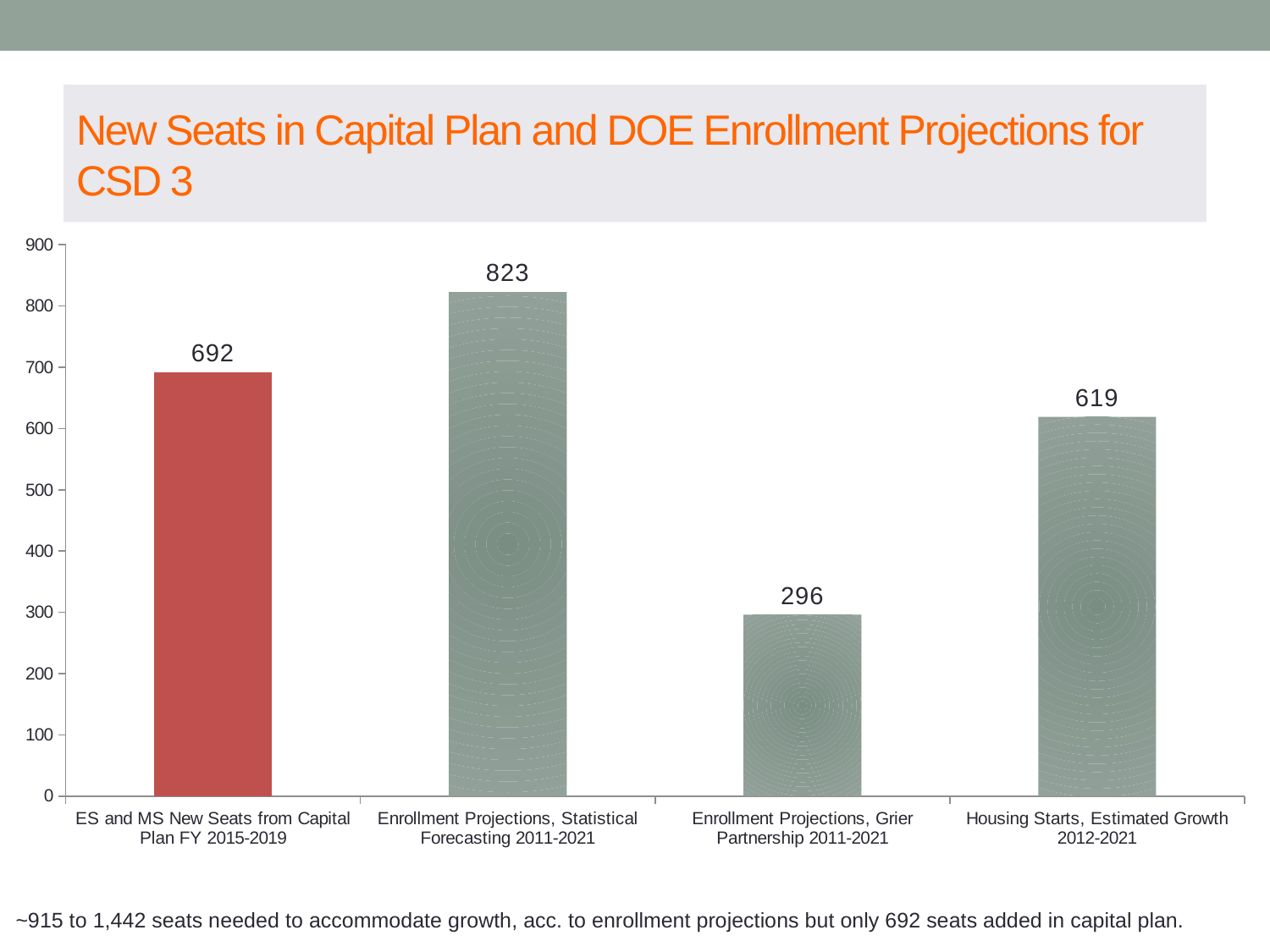
What is the difference between Housing Starts, Estimated Growth 2012-2021 and Enrollment Projections, Grier Partnership 2011-2021? 323 What is the value for Enrollment Projections, Statistical Forecasting 2011-2021? 823 Which category has the lowest value? Enrollment Projections, Grier Partnership 2011-2021 What is the value for Housing Starts, Estimated Growth 2012-2021? 619 What is the difference between the Statistical Forecasting projection and the new seats from the Capital Plan? 131 Which category has the highest value? Enrollment Projections, Statistical Forecasting 2011-2021 What is the value for ES and MS New Seats from Capital Plan FY 2015-2019? 692 Which bar is shown in a different colour (red) from the others? ES and MS New Seats from Capital Plan FY 2015-2019 What kind of chart is shown on the slide? Bar chart Which is larger: ES and MS New Seats from Capital Plan FY 2015-2019 or Housing Starts, Estimated Growth 2012-2021? ES and MS New Seats from Capital Plan FY 2015-2019 How many categories are shown on the chart? 4 What is the value for Enrollment Projections, Grier Partnership 2011-2021? 296